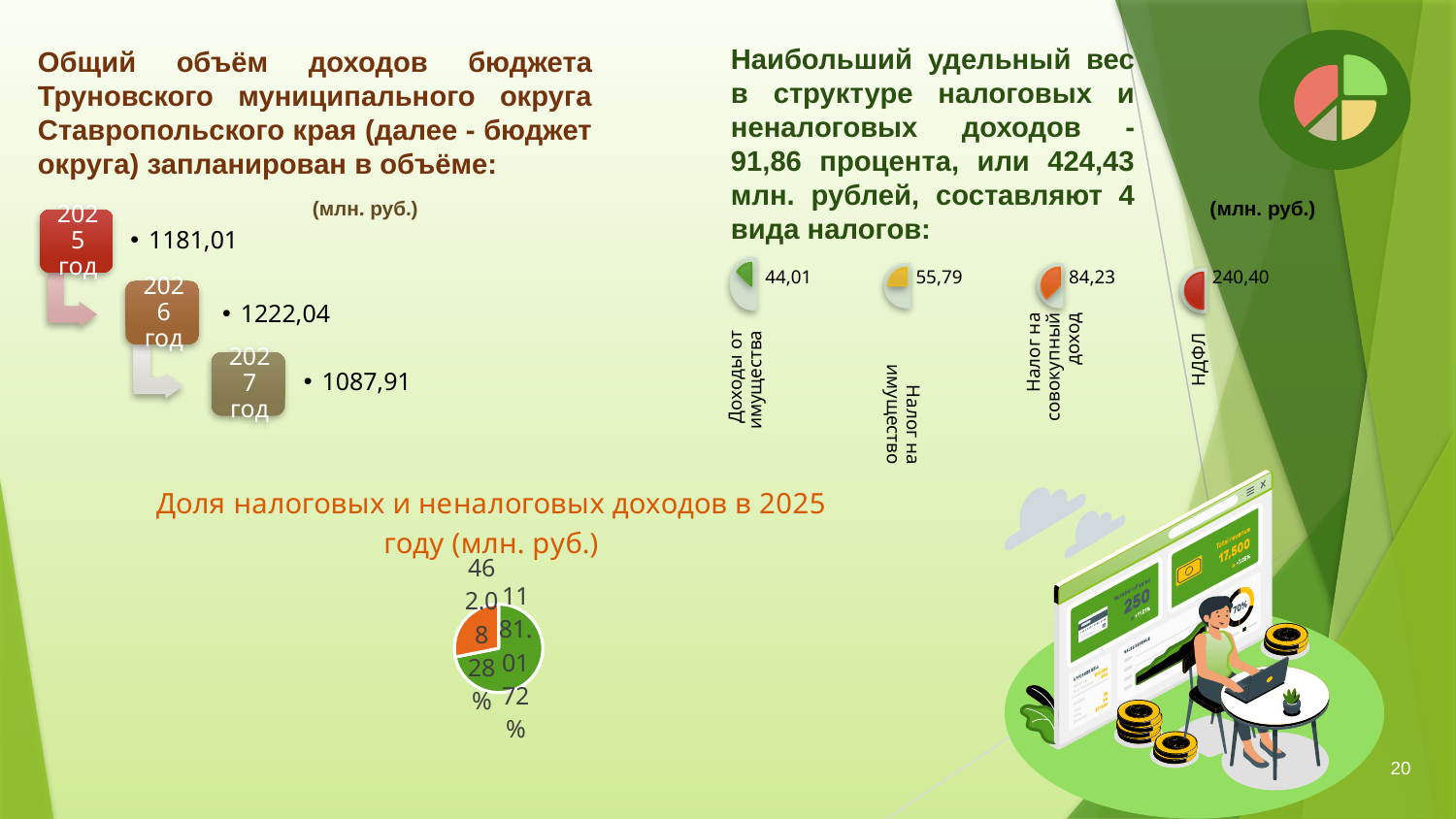
In the chart on the right showing the four types of taxes, what is the value for Налог на имущество? 55,79 How many categories are shown in the chart on the right showing the types of taxes? 4 In the chart on the right showing the four types of taxes, which category has the highest value? НДФЛ In the chart on the right showing the four types of taxes, what is the difference between the values for Налог на имущество and Доходы от имущества? 11,78 How many slices does the pie chart at the bottom of the slide have? 2 In the chart on the right showing the four types of taxes, what is the value for НДФЛ? 240,40 In the chart on the right showing the four types of taxes, which is larger: Налог на имущество or Доходы от имущества? Налог на имущество What kind of chart is the one at the bottom titled 'Доля налоговых и неналоговых доходов в 2025 году (млн. руб.)'? pie chart In the chart on the right showing the four types of taxes, what is the value for Налог на совокупный доход? 84,23 In the chart on the right showing the four types of taxes, what is the difference between the values for НДФЛ and Налог на совокупный доход? 156,17 In the chart on the right showing the four types of taxes, what is the value for Доходы от имущества? 44,01 In the chart on the right showing the four types of taxes, which category has the lowest value? Доходы от имущества